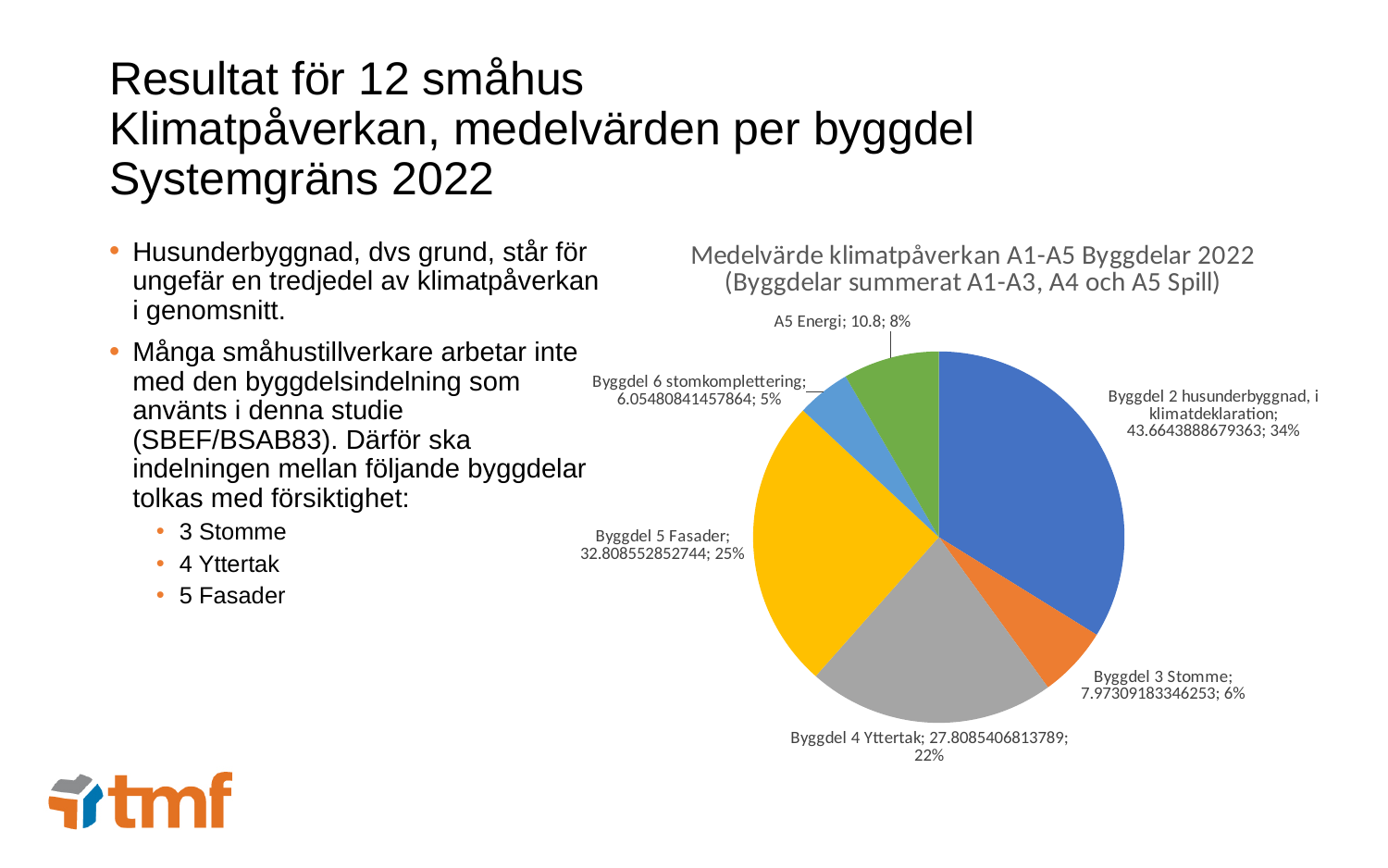
What is the value shown for A5 Energi? 10.8 What is the title of the pie chart? Medelvärde klimatpåverkan A1-A5 Byggdelar 2022 (Byggdelar summerat A1-A3, A4 och A5 Spill) Which slice of the pie chart is the smallest? Byggdel 6 stomkomplettering What percentage is shown for Byggdel 4 Yttertak? 22% Which is larger, Byggdel 3 Stomme or Byggdel 4 Yttertak? Byggdel 4 Yttertak How many slices does the pie chart have? 6 What percentage is shown for Byggdel 6 stomkomplettering? 5% What is the difference in percentage points between Byggdel 5 Fasader and Byggdel 3 Stomme? 19 percentage points What share of the pie does Byggdel 2 husunderbyggnad, i klimatdeklaration represent? 34% What is the value shown for Byggdel 5 Fasader? 32.808552852744 What kind of chart is shown on the slide? Pie chart Which slice of the pie chart is the largest? Byggdel 2 husunderbyggnad, i klimatdeklaration